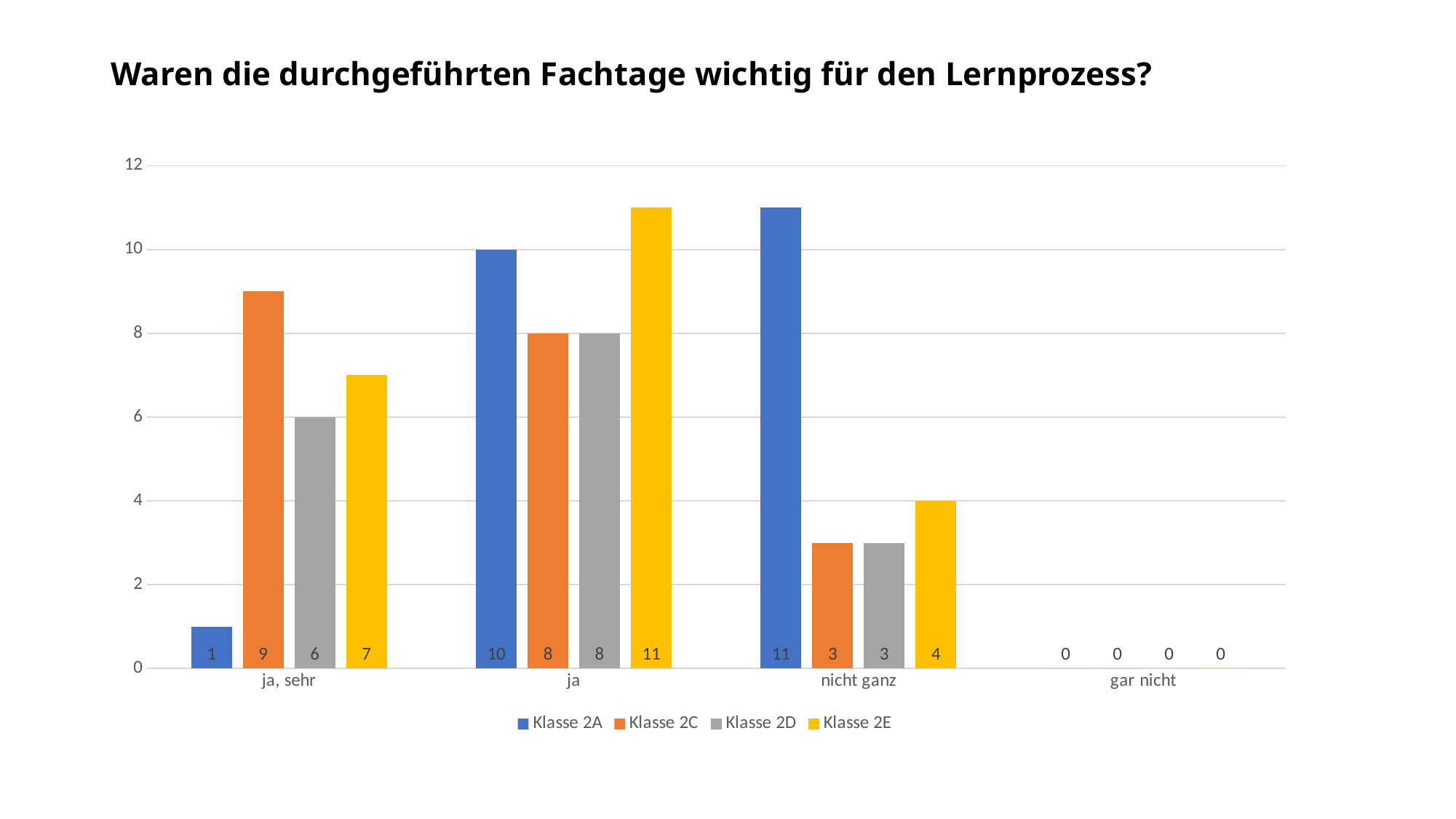
What is the difference between Klasse 2A and Klasse 2E in the "nicht ganz" category? 7 How many categories are shown on the x axis? 4 What is the value for every series in the "gar nicht" category? 0 Which series has the lowest value in the "nicht ganz" category? Klasse 2C and Klasse 2D (both 3) What is the title of the chart? Waren die durchgeführten Fachtage wichtig für den Lernprozess? Which series has the highest value in the "ja, sehr" category? Klasse 2C What is the value for Klasse 2C in the "nicht ganz" category? 3 What is the value for Klasse 2A in the "ja, sehr" category? 1 What is the value for Klasse 2E in the "ja" category? 11 How many series does the legend list? 4 What kind of chart is shown on the slide? Bar chart Which is larger: Klasse 2D in "ja, sehr" or Klasse 2D in "ja"? Klasse 2D in "ja"